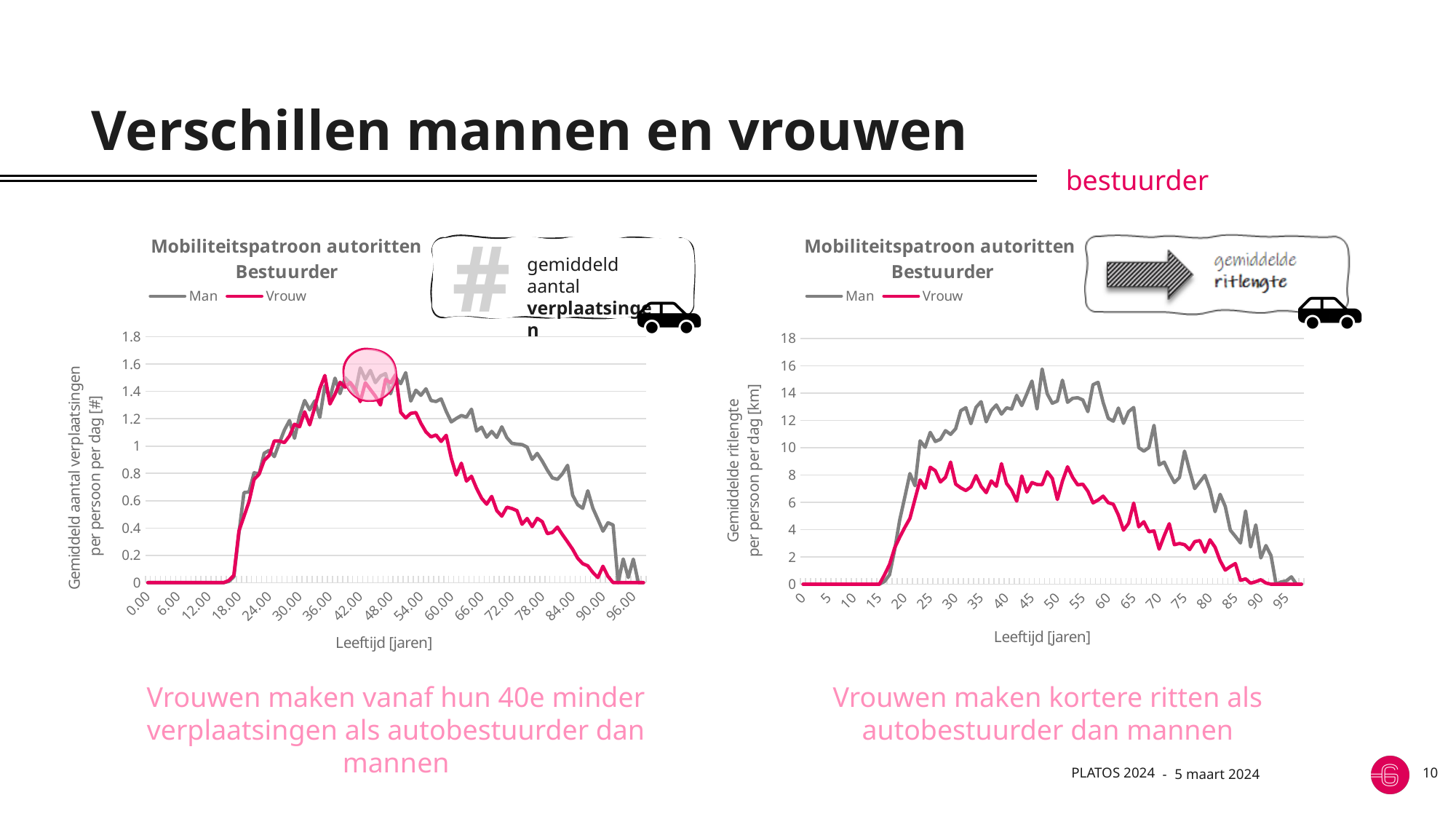
In the right chart, is the value for Vrouw at age 50 greater or less than 10? less In the right chart, is the value for Vrouw at age 75 greater or less than 6? less Which two series are shown in the legend of the left chart? Man and Vrouw What is the x-axis title of the right chart? Leeftijd [jaren] What kind of chart is the left chart (Mobiliteitspatroon autoritten Bestuurder, aantal verplaatsingen)? Line chart In the left chart, is the value for Man at age 66 greater or less than 1? greater How many series does the legend of the right chart (gemiddelde ritlengte) list? 2 In the left chart, does the Man series rise or fall between age 54 and age 90? Fall In the right chart, which series has the higher value at age 60, Man or Vrouw? Man